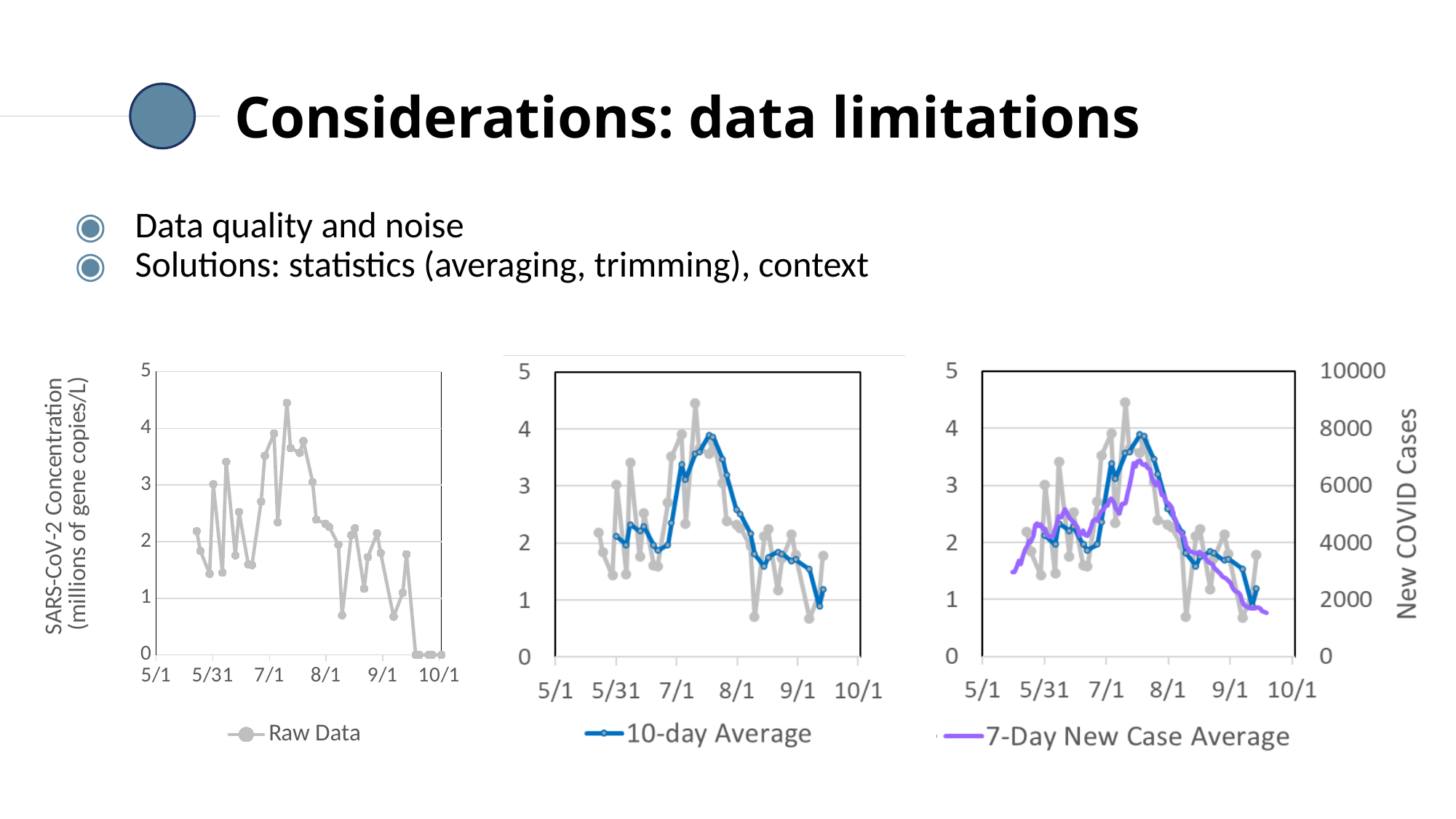
How many series does the legend of the left chart list? 1 What kind of chart is the left chart labelled 'Raw Data'? line chart In the middle chart, does the 10-day Average rise or fall between 7/1 and its peak in mid-July? rise In the right chart, what is the maximum value shown on the right-hand y axis? 10000 In the left chart, is the highest Raw Data value greater or less than 4? greater In the middle chart, is the peak of the 10-day Average greater or less than 3? greater In the left chart, are the Raw Data values at the end of September (just before 10/1) greater or less than 1? less In the left chart, what is the legend entry for the plotted series? Raw Data In the middle chart, does the 10-day Average rise or fall between 8/1 and 9/1? fall In the right chart, what is the label of the secondary (right-hand) y axis? New COVID Cases How many date tick labels are shown on the x axis of the left chart? 6